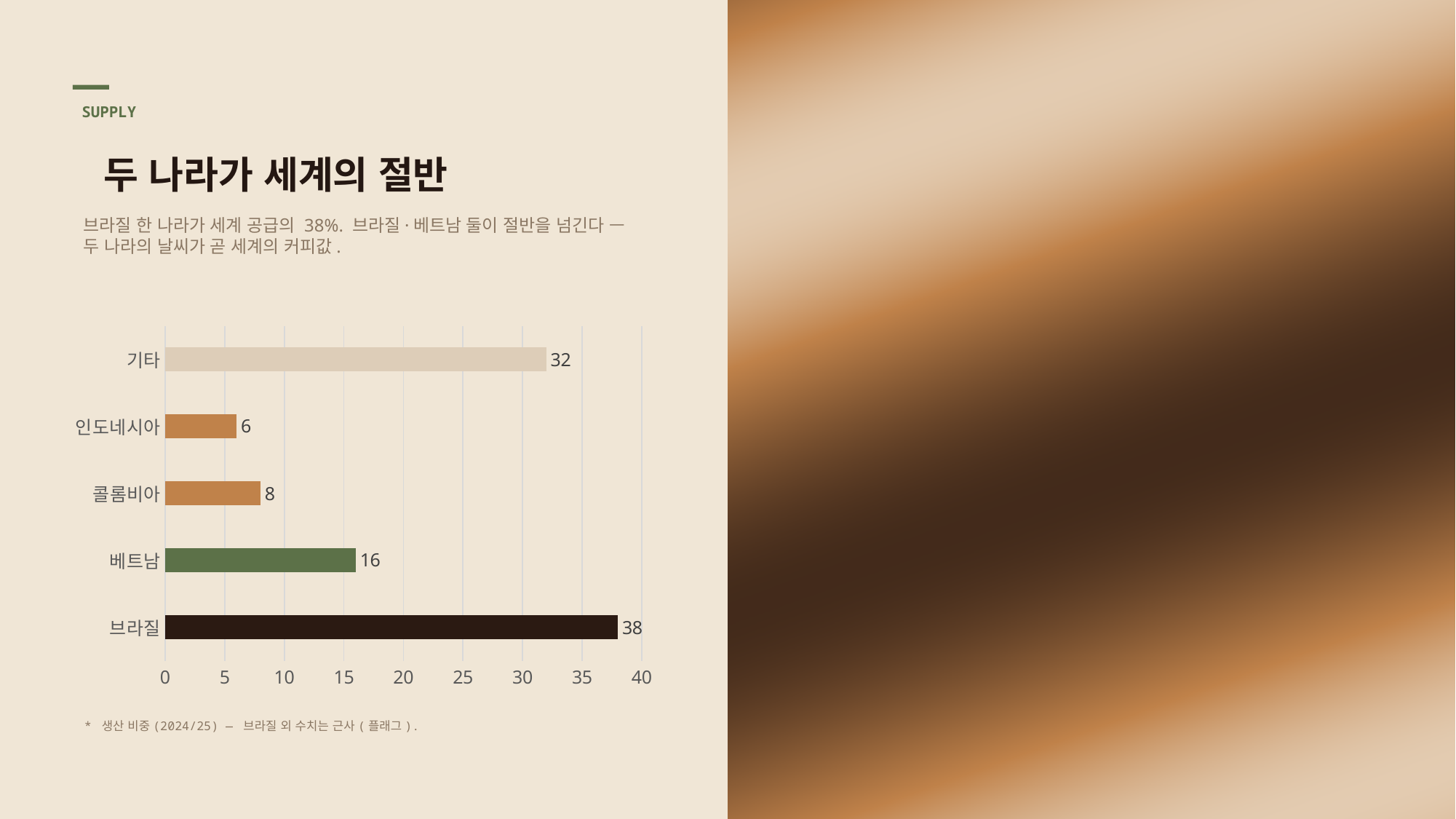
Is the value for 기타 greater or less than 30? greater What is the value for 기타? 32 How many categories are shown in the chart? 5 Which is larger, the value for 콜롬비아 or the value for 인도네시아? 콜롬비아 What is the value for 브라질? 38 Which category has the highest value? 브라질 Which category has the lowest value? 인도네시아 What is the value for 인도네시아? 6 What is the difference between the values for 브라질 and 베트남? 22 What is the value for 베트남? 16 What kind of chart is shown on the slide? bar chart What is the value for 콜롬비아? 8